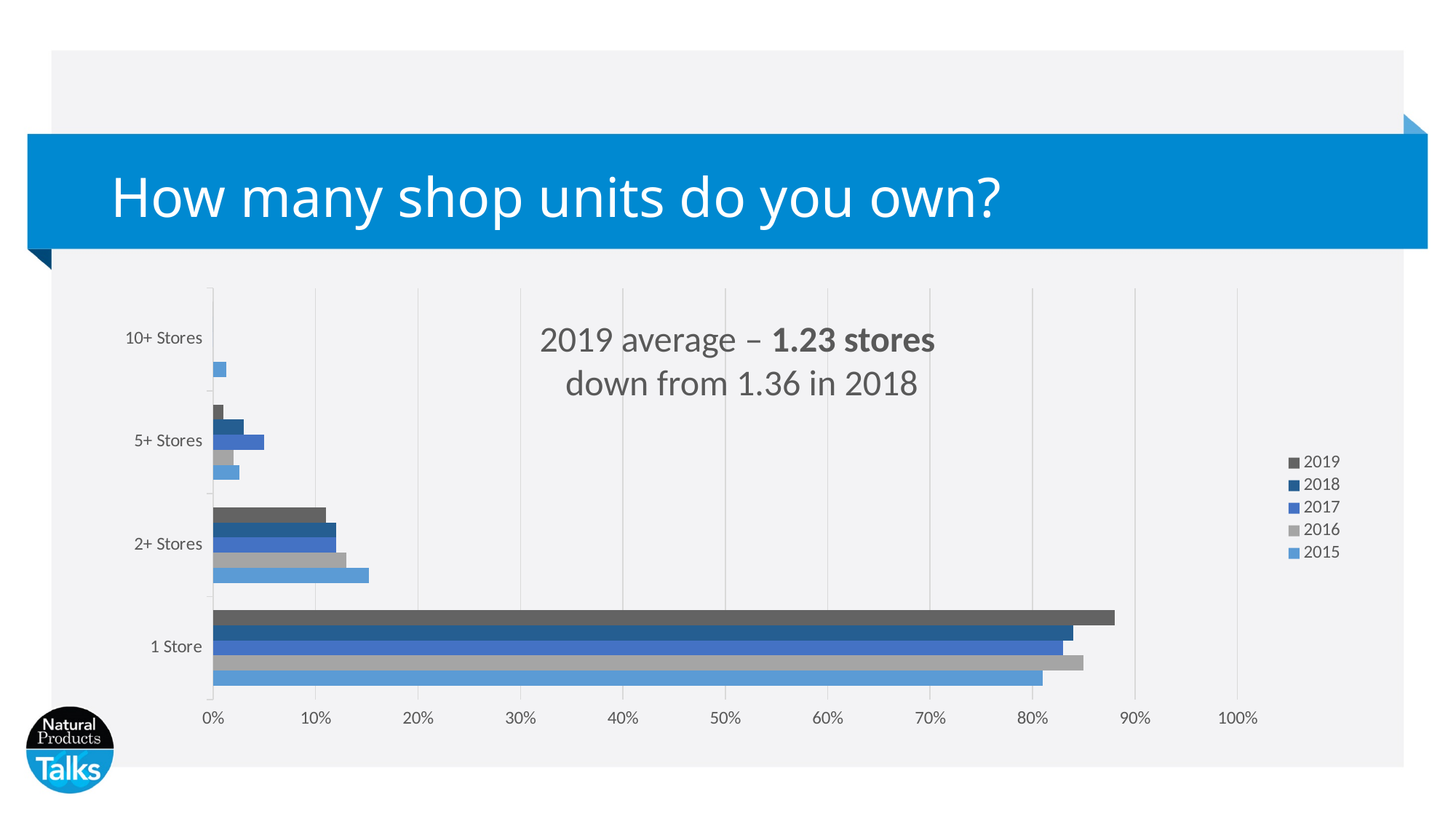
What kind of chart is shown on the slide? bar chart How many store-count categories are shown on the y axis of the chart? 4 Is the 2019 value for 1 Store greater or less than 80%? greater How many series does the chart's legend list? 5 For 1 Store, which is larger: the 2019 value or the 2015 value? 2019 For 5+ Stores, which is larger: the 2017 value or the 2019 value? 2017 Is the 2015 value for 2+ Stores greater or less than 10%? greater Which year has the highest value for 1 Store? 2019 Which year has the highest value for 2+ Stores? 2015 According to the text on the chart, what was the 2019 average number of stores? 1.23 stores Is the 2015 value for 2+ Stores greater or less than 20%? less